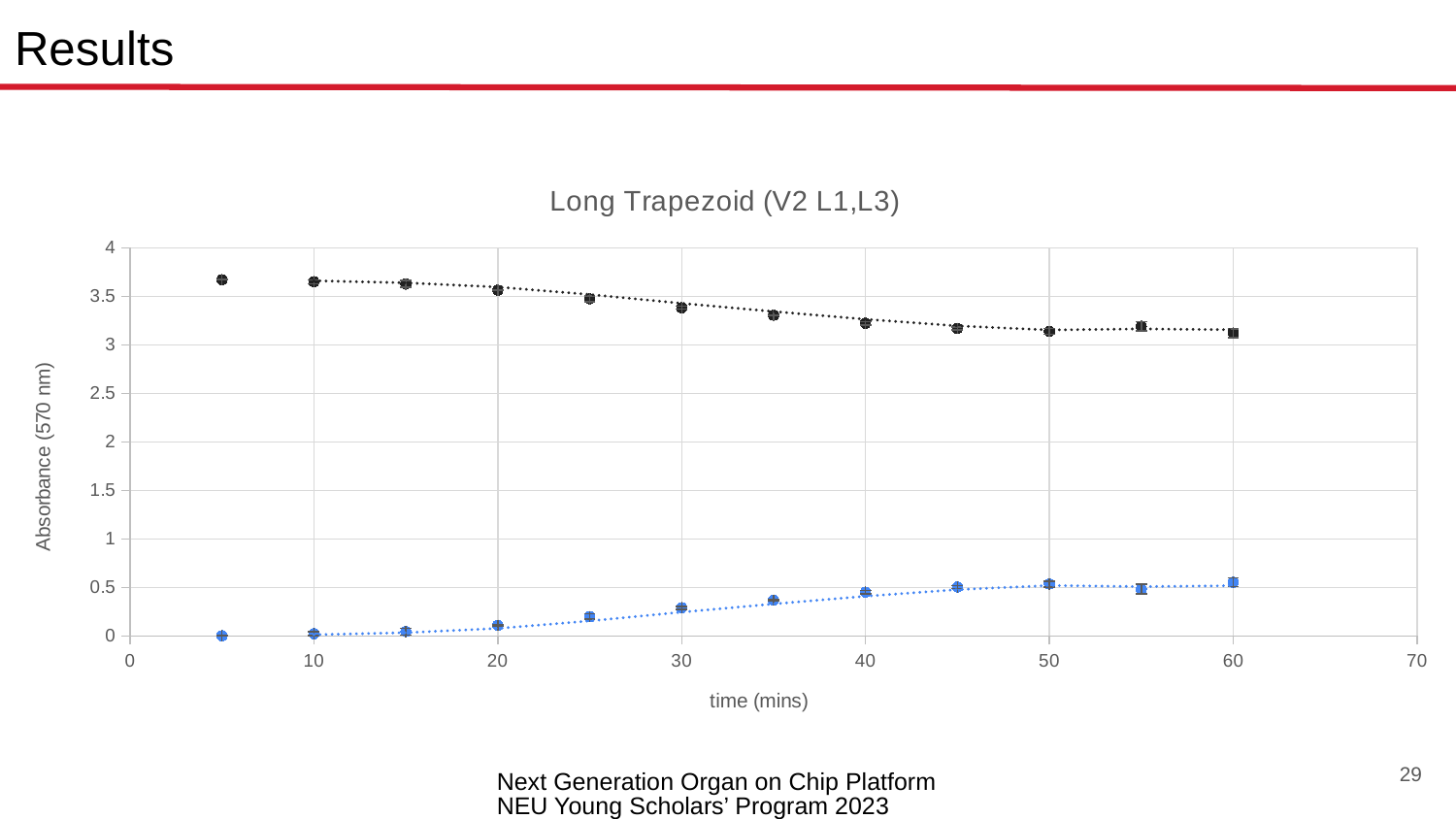
Do the values of the black series rise or fall as time increases? fall How many data series are plotted on the chart? 2 What kind of chart is shown on the slide? scatter chart Is the value of the blue series at 30 mins greater or less than 0.5? less What is the label of the y axis? Absorbance (570 nm) How many data points does the black series have? 12 What is the title of the chart? Long Trapezoid (V2 L1,L3) Is the value of the black series at 40 mins greater or less than 3? greater Is the value of the black series at 5 mins greater or less than 3.5? greater At 30 mins, which series has the larger value, the black series or the blue series? the black series Do the values of the blue series rise or fall as time increases? rise